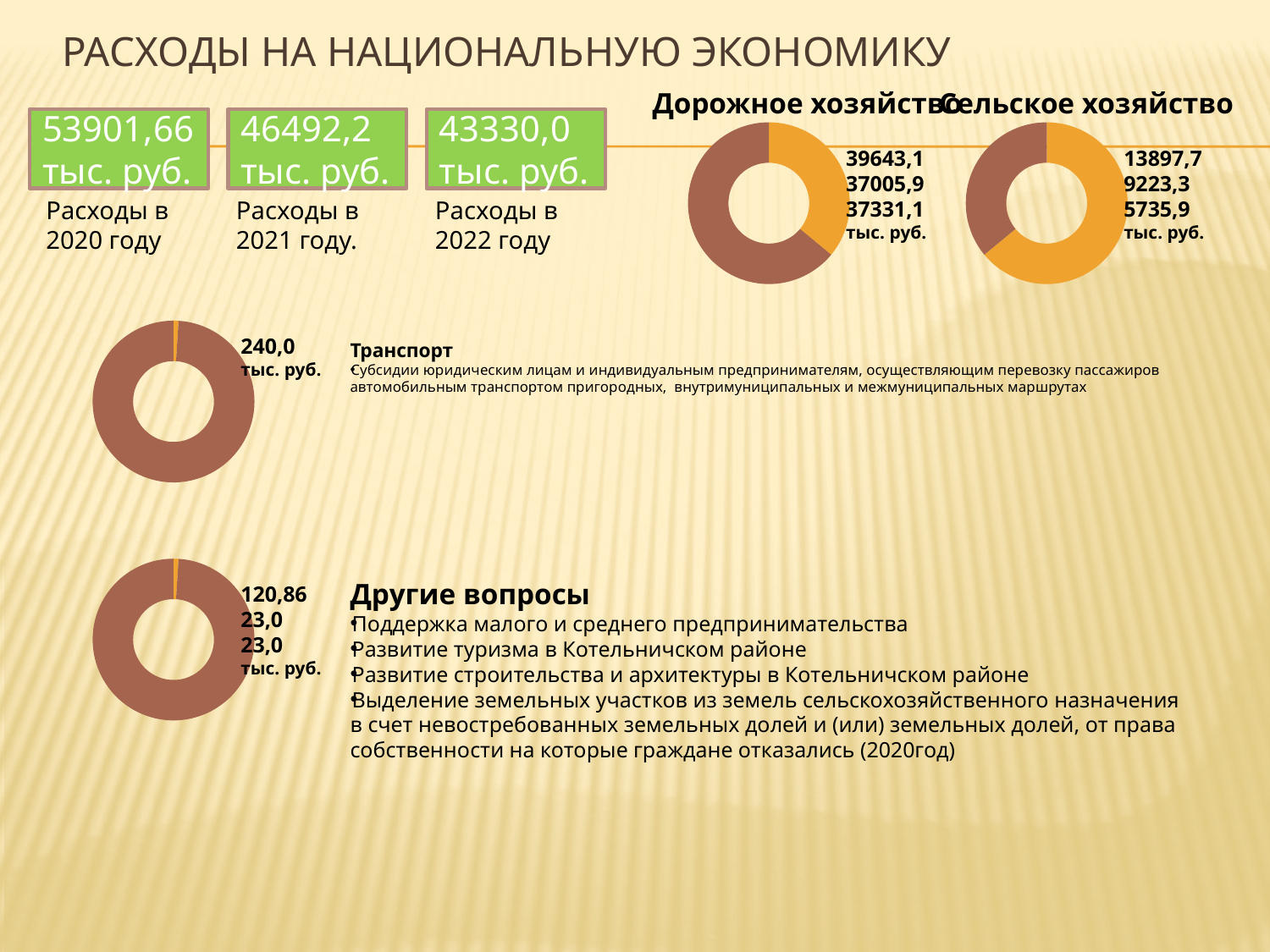
What is the largest value listed beside the Сельское хозяйство chart? 13897,7 How many values are listed beside the Другие вопросы doughnut chart? 3 Which is larger: the first value beside the Дорожное хозяйство chart (39643,1) or the first value beside the Сельское хозяйство chart (13897,7)? 39643,1 (Дорожное хозяйство) What is the title of the doughnut chart on the far right of the top row? Сельское хозяйство How many doughnut charts are shown on the slide? 4 What is the smallest value listed beside the Сельское хозяйство chart? 5735,9 What value is shown beside the doughnut chart for Транспорт? 240,0 тыс. руб. What unit is given for the values beside the Дорожное хозяйство chart? тыс. руб. What is the difference between the largest and smallest values listed beside the Сельское хозяйство chart? 8161,8 What is the first value listed beside the Дорожное хозяйство chart? 39643,1 What is the largest value listed beside the Другие вопросы doughnut chart? 120,86 What kind of chart is used for Дорожное хозяйство? Doughnut chart